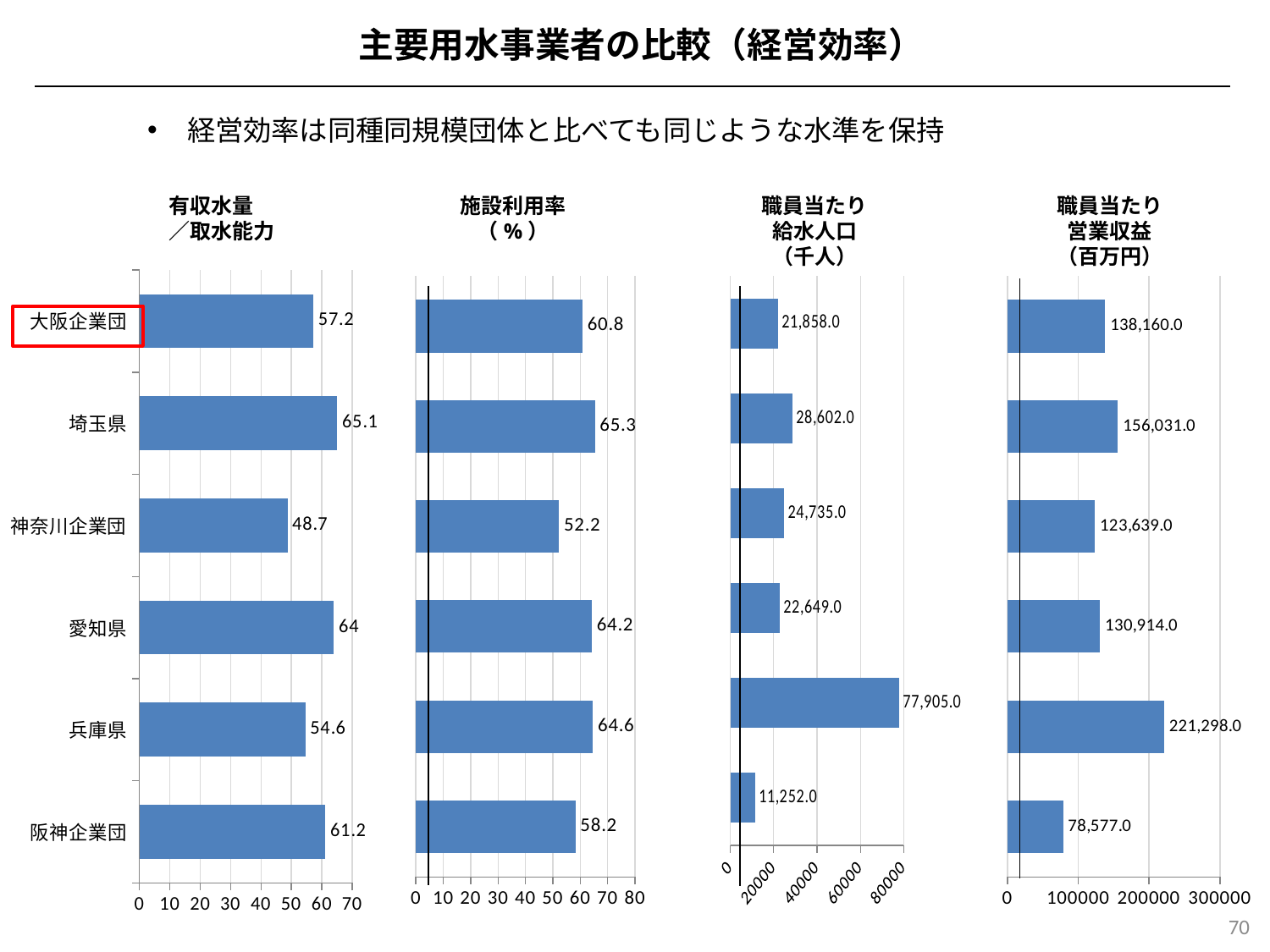
In the 有収水量／取水能力 chart, what is the value for 大阪企業団? 57.2 In the 有収水量／取水能力 chart, which category has the lowest value? 神奈川企業団 In the 職員当たり営業収益（百万円） chart, what is the value for 大阪企業団? 138,160.0 In the 有収水量／取水能力 chart, which category has the highest value? 埼玉県 How many categories are shown in the 有収水量／取水能力 chart? 6 In the 職員当たり営業収益（百万円） chart, is the value for 兵庫県 greater or less than 200000? greater In the 施設利用率（%） chart, which category has the lowest value? 神奈川企業団 In the 施設利用率（%） chart, what is the value for 兵庫県? 64.6 In the 職員当たり営業収益（百万円） chart, which is larger, 埼玉県 or 愛知県? 埼玉県 In the 職員当たり給水人口（千人） chart, which category has the lowest value? 阪神企業団 In the 施設利用率（%） chart, what is the difference between 埼玉県 and 大阪企業団? 4.5 In the 職員当たり給水人口（千人） chart, what is the value for 兵庫県? 77,905.0